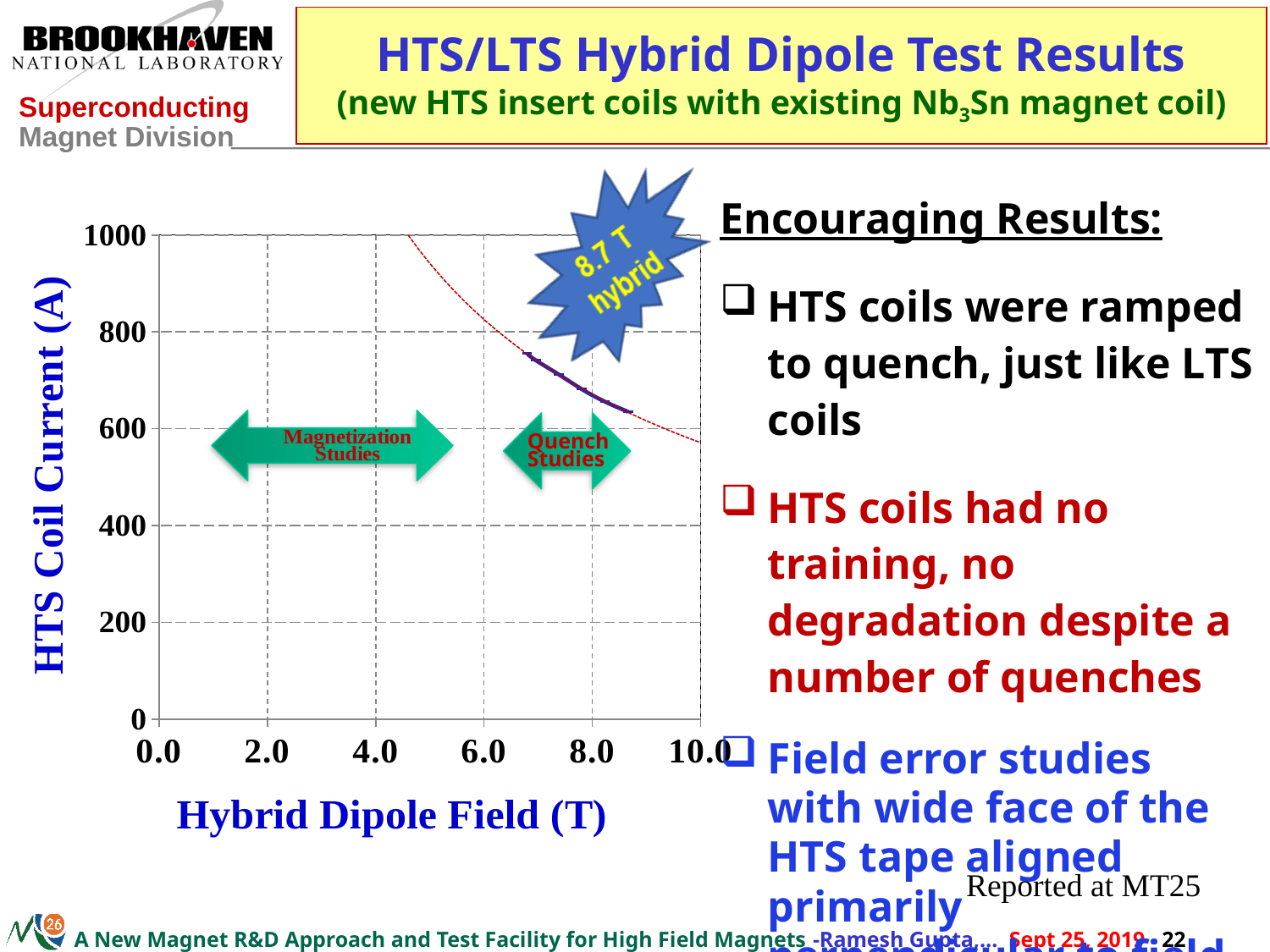
As the hybrid dipole field increases along the x axis, does the HTS coil current of the plotted points rise or fall? fall Are the plotted data points located at hybrid dipole fields greater or less than 6.0 T? greater What is the title of the vertical axis of the chart? HTS Coil Current (A) What is the highest value shown on the vertical axis of the chart? 1000 What is the highest value shown on the horizontal axis of the chart? 10.0 Is the HTS coil current of the plotted points at a hybrid dipole field of 8.0 T greater or less than 600 A? greater What hybrid dipole field value is highlighted in the starburst callout on the chart? 8.7 T hybrid How many tick labels are shown on the horizontal axis of the chart? 6 Is the HTS coil current of the plotted points at a hybrid dipole field of 7.0 T greater or less than 800 A? less What kind of chart is shown on the slide? scatter (line) chart